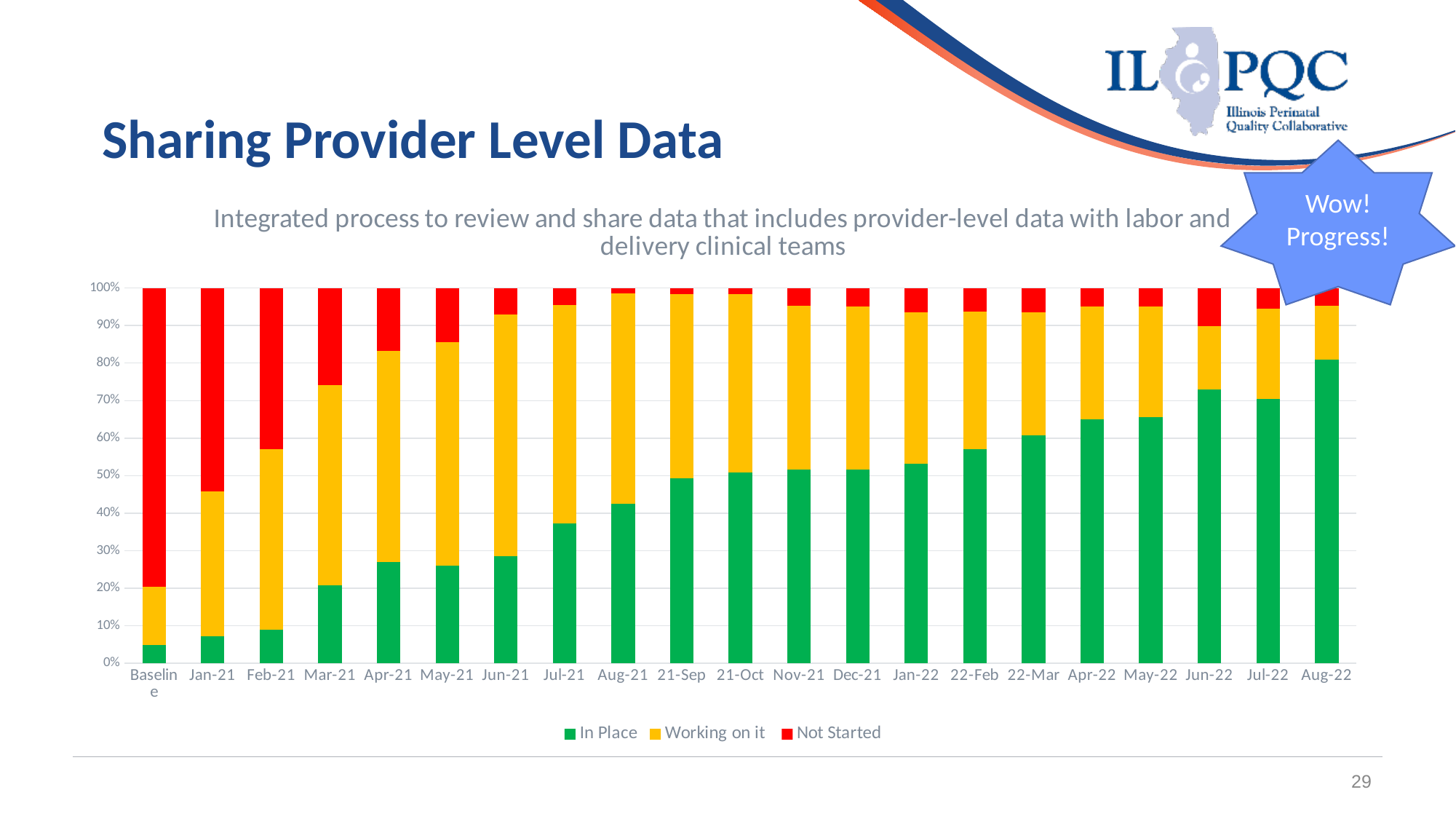
Which category has the lowest In Place value? Baseline Which colour represents the Not Started series in the legend? Red Which category has the highest In Place value? Aug-22 Does the In Place series generally rise or fall from Baseline to Aug-22? Rise Is the In Place value for Aug-22 greater or less than 70%? greater Which is larger, the Not Started value for Baseline or for Aug-22? Baseline Is the In Place value for Mar-21 greater or less than 30%? less How many categories are shown along the x axis? 21 What is the total of the stacked bar for Jun-21? 100% What kind of chart is shown on the slide? Stacked bar chart Is the In Place value for Jan-21 greater or less than 10%? less How many series does the legend list? 3